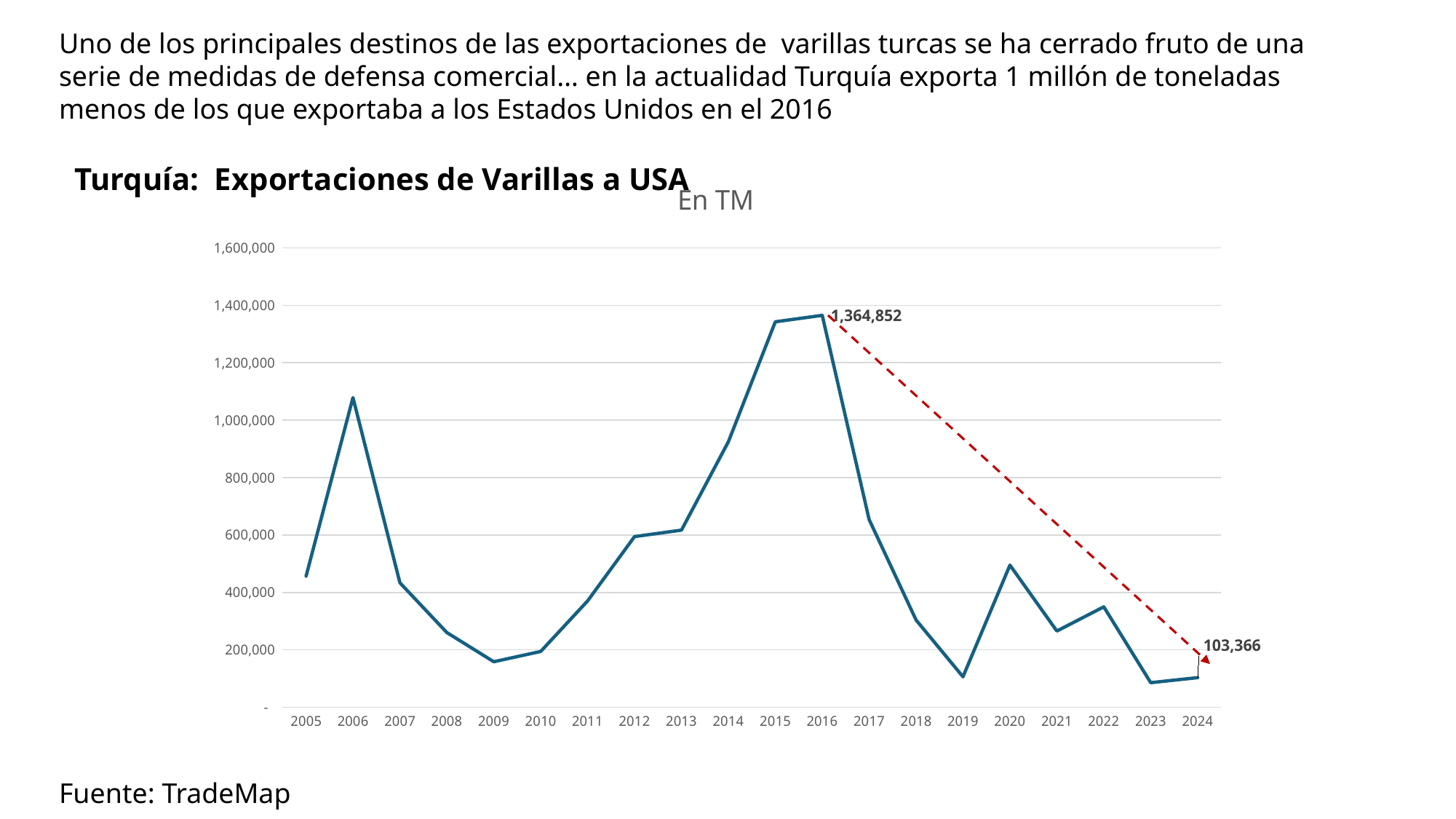
Is the value for 2006 greater or less than 1,000,000? greater Is the value for 2009 greater or less than 200,000? less Which year has the larger value, 2020 or 2021? 2020 What unit is indicated under the chart title? TM What is the value of Turkey's rebar exports to the USA in 2016? 1,364,852 What is the difference between the 2016 value and the 2024 value? 1,261,486 Is the value for 2018 greater or less than 400,000? less What kind of chart is shown on the slide? Line chart Which year has the larger value, 2006 or 2007? 2006 What is the value of Turkey's rebar exports to the USA in 2024? 103,366 How many years are plotted on the x axis? 20 Do the values rise or fall from 2016 to 2019? Fall